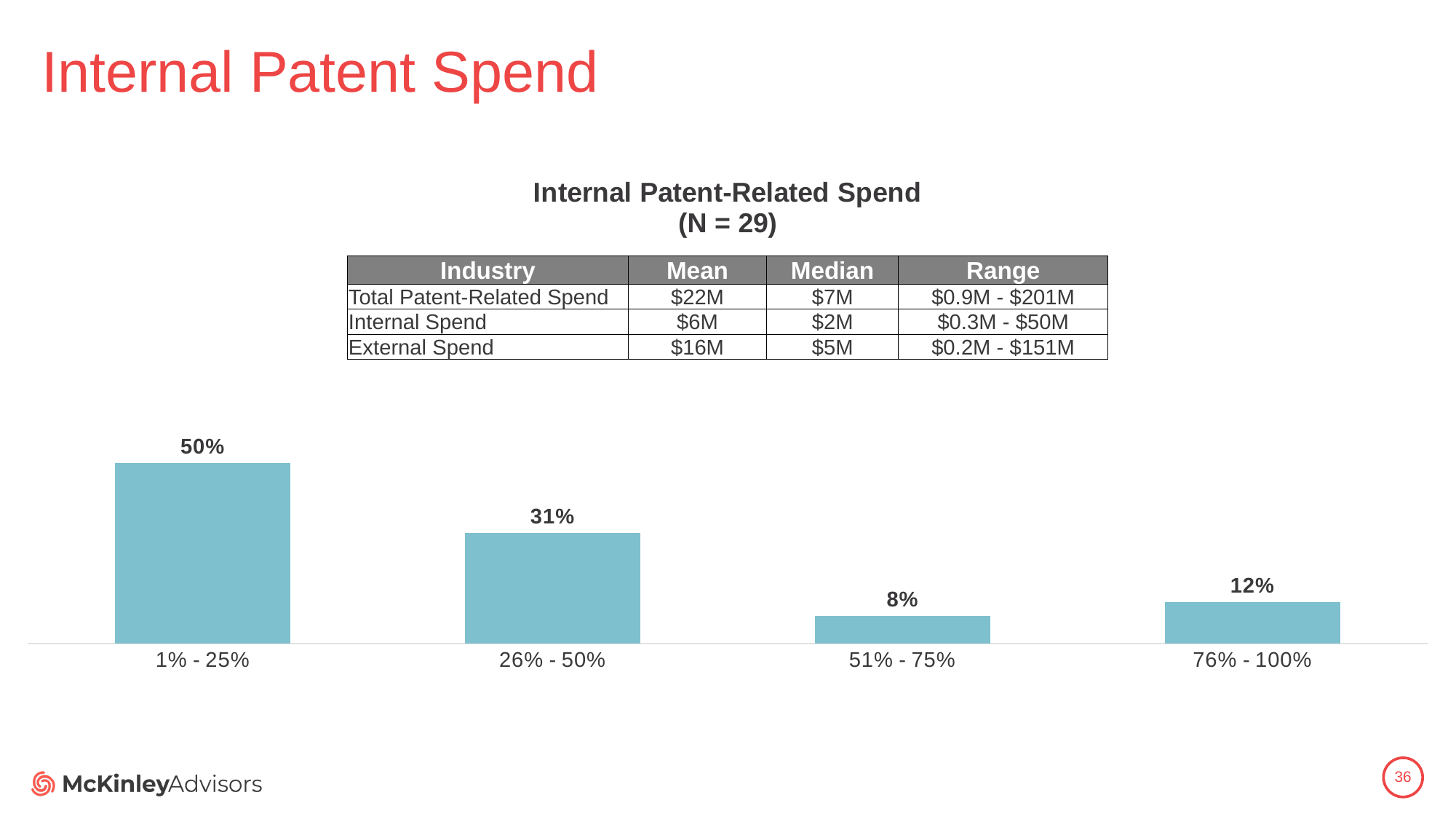
What kind of chart is shown on the slide? Bar chart What is the value for the 26% - 50% category? 31% What colour are the bars in the chart? Light blue What is the value for the 1% - 25% category? 50% What is the value for the 51% - 75% category? 8% What is the difference between the values for 76% - 100% and 51% - 75%? 4% Which category has the highest value? 1% - 25% Which category has the lowest value? 51% - 75% How many categories are shown in the bar chart? 4 What is the value for the 76% - 100% category? 12% What is the difference between the values for 1% - 25% and 26% - 50%? 19% Which is larger, the value for 26% - 50% or the value for 76% - 100%? 26% - 50%